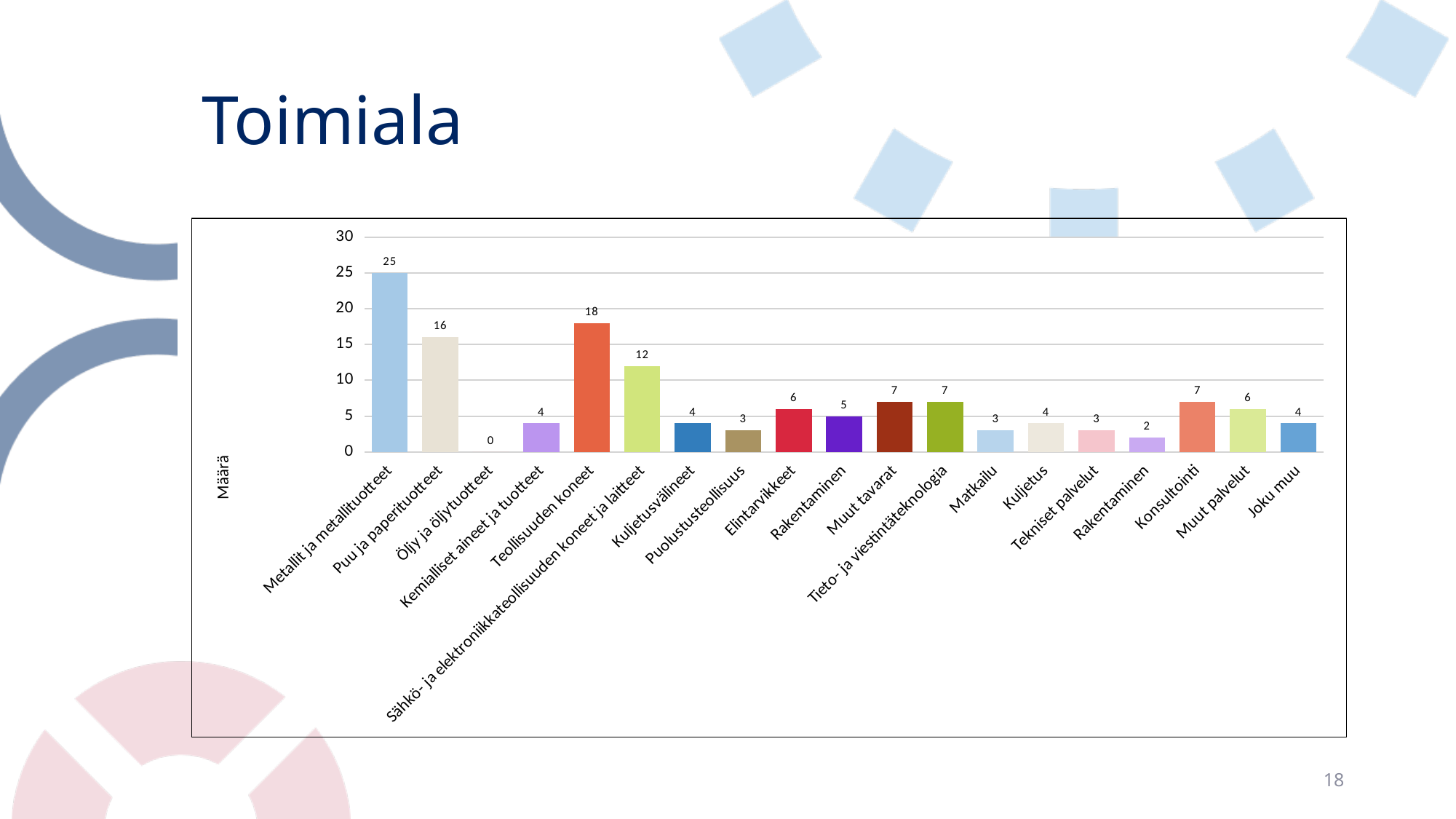
What is the value for Metallit ja metallituotteet? 25 What is the difference between the values for Metallit ja metallituotteet and Puu ja paperituotteet? 9 What kind of chart is shown on the slide? bar chart What is the value for Konsultointi? 7 How many categories are shown on the x axis? 19 Which is larger, the value for Teollisuuden koneet or the value for Puu ja paperituotteet? Teollisuuden koneet What is the value for Sähkö- ja elektroniikkateollisuuden koneet ja laitteet? 12 Is the value for Sähkö- ja elektroniikkateollisuuden koneet ja laitteet greater or less than 10? greater Which category has the lowest value? Öljy ja öljytuotteet What is the label of the vertical axis? Määrä Which category has the highest value? Metallit ja metallituotteet What is the value for Teollisuuden koneet? 18